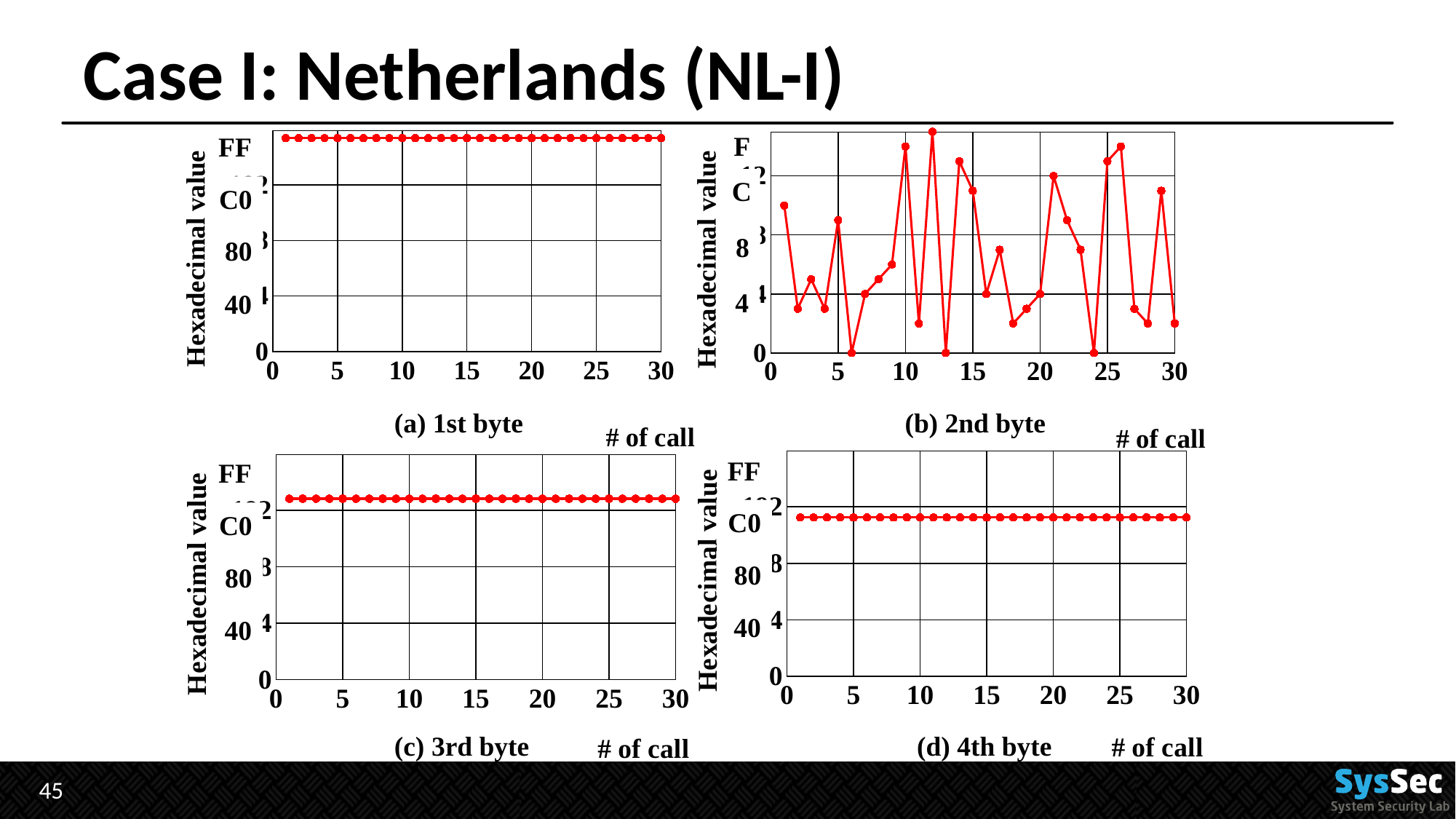
In chart (a) 1st byte, do the values rise, fall, or stay constant as the number of calls increases? stay constant What is the x-axis label shown on the charts? # of call What kind of chart is chart (a) 1st byte? line chart In chart (d) 4th byte, is the value at call 15 greater or less than C0? less How many data points are plotted in chart (b) 2nd byte? 30 In chart (b) 2nd byte, what is the value at call 6? 0 In chart (b) 2nd byte, is the value at call 18 greater or less than 4? less In chart (b) 2nd byte, is the value at call 10 greater or less than 8? greater In chart (b) 2nd byte, at which call number is the value highest? 12 At call 10, which chart shows the larger value: chart (c) 3rd byte or chart (d) 4th byte? chart (c) 3rd byte